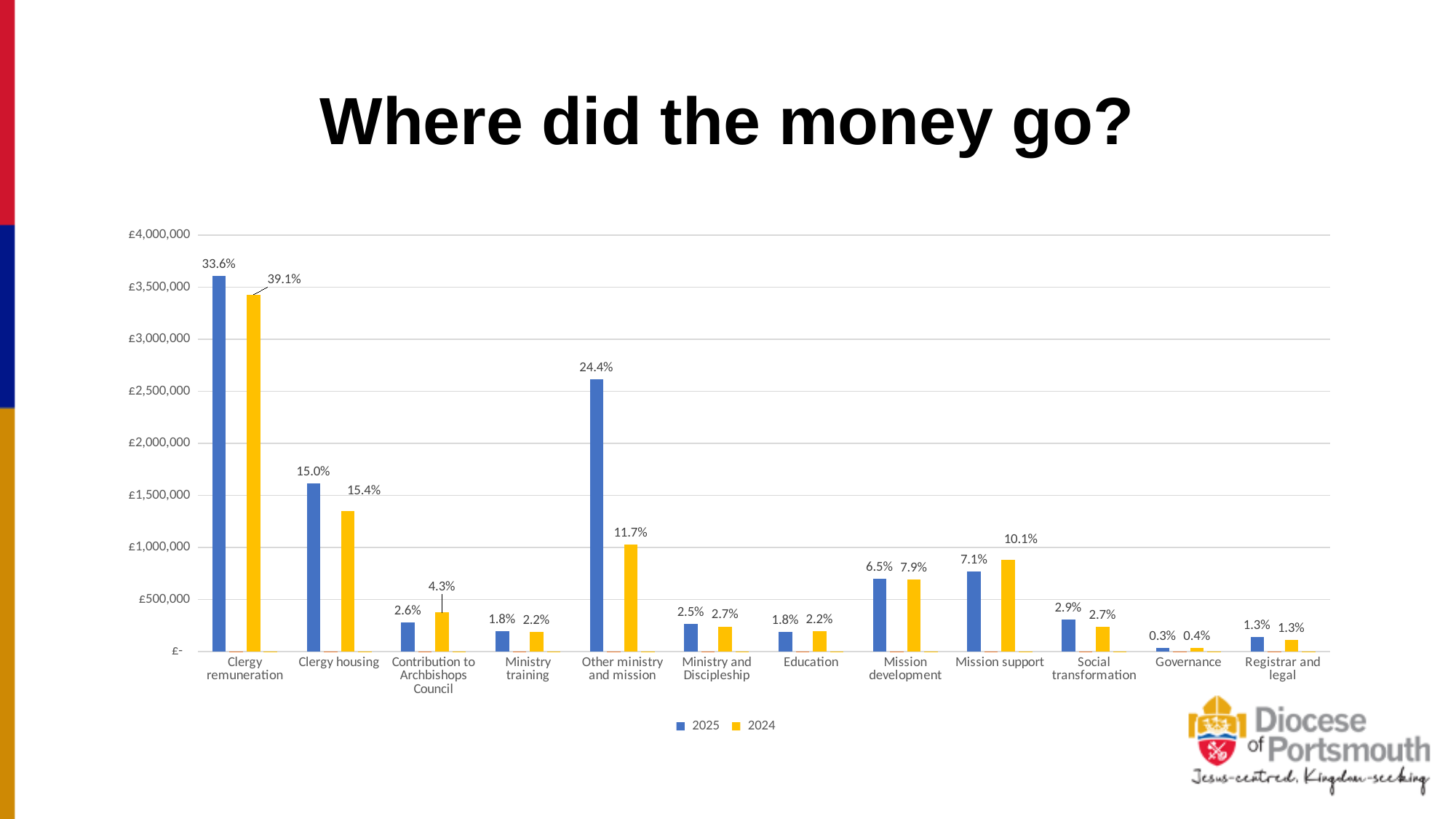
How many categories are shown along the x axis? 12 What percentage label is shown on the 2024 bar for Other ministry and mission? 11.7% Which category has the tallest 2025 bar? Clergy remuneration Is the 2024 value for Mission support greater or less than £1,000,000? less What percentage label is shown on the 2024 bar for Mission support? 10.1% For Clergy remuneration, which bar is taller, 2025 or 2024? 2025 Is the 2025 value for Other ministry and mission greater or less than £2,000,000? greater What kind of chart is shown on the slide? Bar chart How many series does the legend list? 2 Which category has the shortest 2025 bar? Governance What percentage label is shown on the 2025 bar for Clergy remuneration? 33.6% What is the difference between the 2024 and 2025 percentage labels for Clergy remuneration? 5.5 percentage points